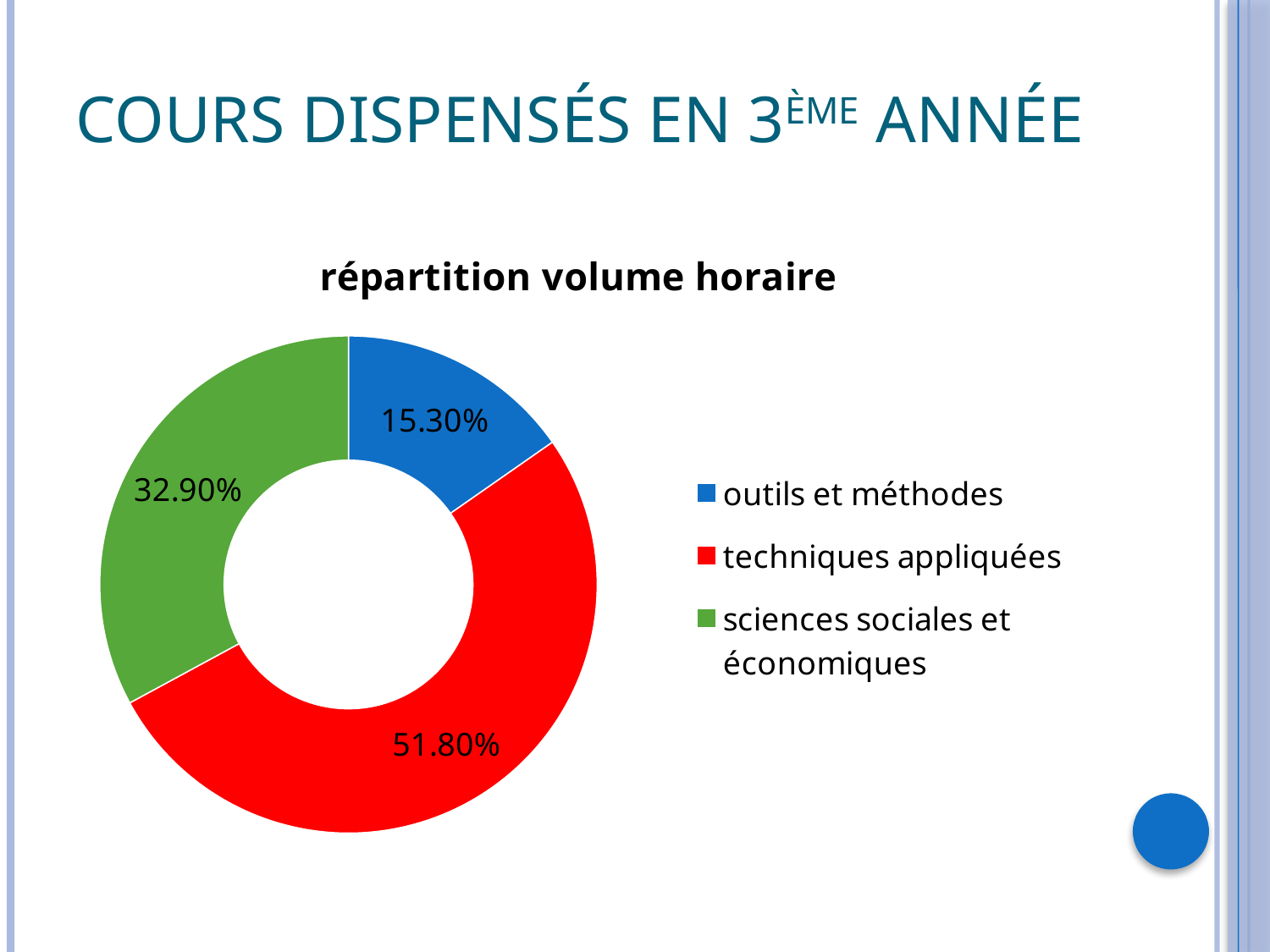
What kind of chart is shown on the slide? Doughnut (pie) chart Which category has the smallest share of the chart? outils et méthodes What share of the chart does 'sciences sociales et économiques' represent? 32.90% Which is larger: the share for 'sciences sociales et économiques' or the share for 'outils et méthodes'? sciences sociales et économiques What is the difference in percentage points between 'techniques appliquées' and 'sciences sociales et économiques'? 18.90 Which category has the largest share of the chart? techniques appliquées Which colour represents 'techniques appliquées' in the chart? Red What share of the chart does 'outils et méthodes' represent? 15.30% What is the title of the chart? répartition volume horaire How many categories does the chart show? 3 What is the difference in percentage points between 'sciences sociales et économiques' and 'outils et méthodes'? 17.60 What share of the chart does 'techniques appliquées' represent? 51.80%